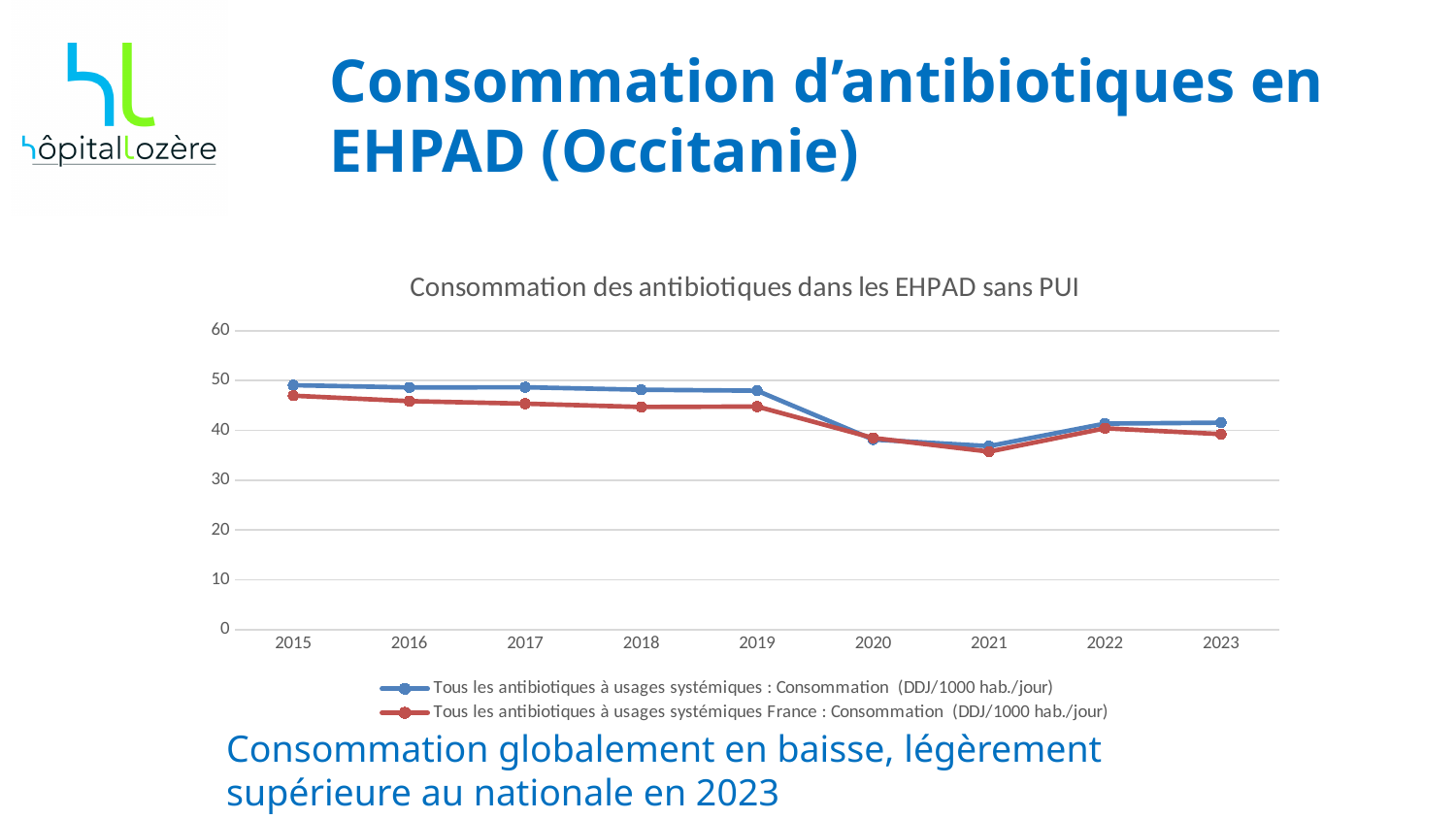
Is the value of the red series (France) in 2015 greater or less than 50? less How many years are plotted along the x axis of the chart? 9 How many series does the chart's legend list? 2 Is the value of the blue series (Occitanie) in 2015 greater or less than 40? greater Is the value of the blue series (Occitanie) in 2021 greater or less than 40? less What is the title of the chart? Consommation des antibiotiques dans les EHPAD sans PUI In 2023, which series has the higher value: the blue series (Occitanie) or the red series (France)? the blue series (Occitanie) Overall, do the values of the blue series rise or fall from 2015 to 2023? fall Which colour is used for the series 'Tous les antibiotiques à usages systémiques France : Consommation (DDJ/1000 hab./jour)'? red What kind of chart is shown on the slide? line chart In which year does the red series (France) reach its lowest value? 2021